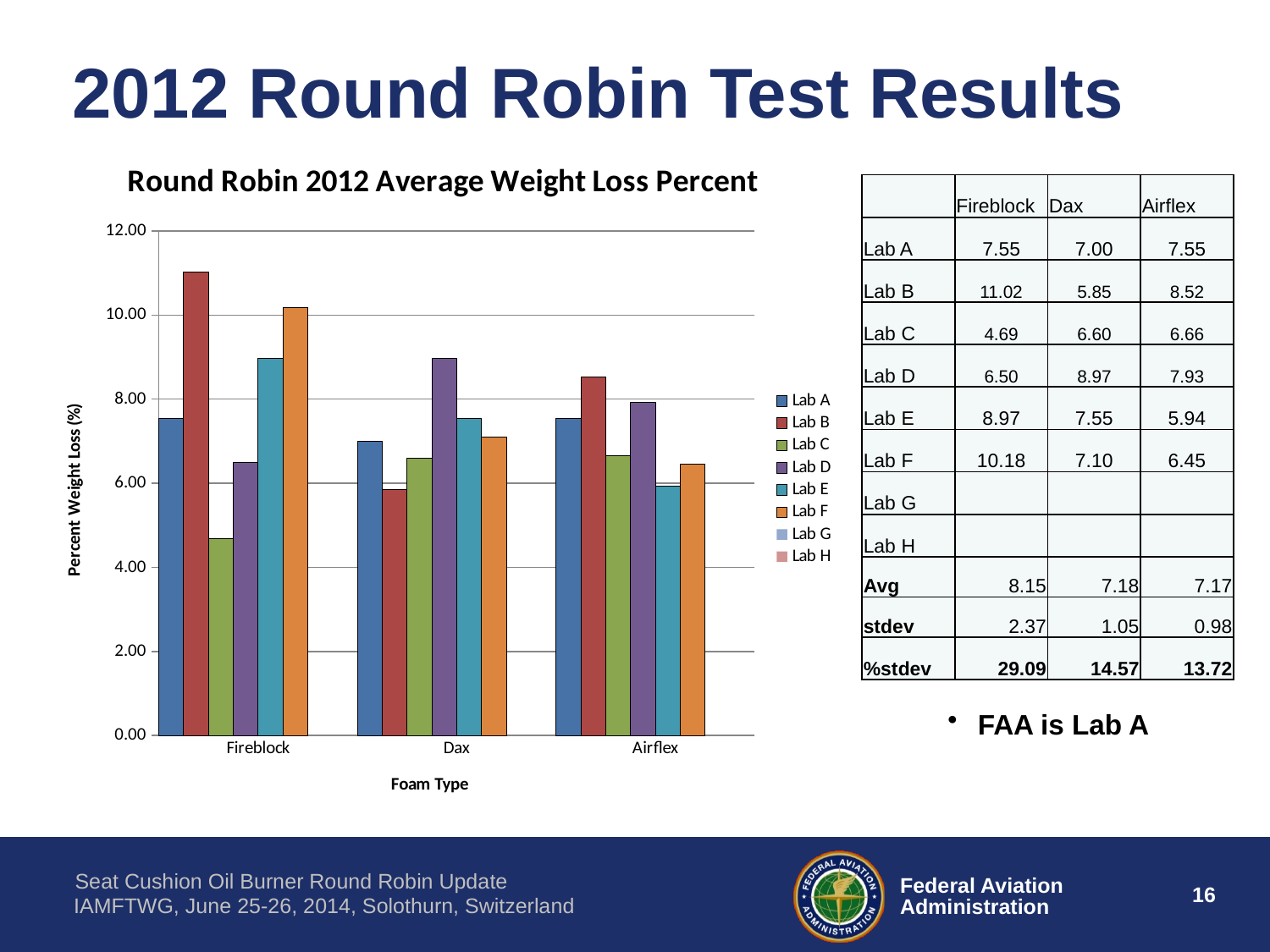
How many series does the chart legend list? 8 How many foam type categories are shown on the x axis? 3 Which lab has the lowest weight loss percent for Airflex? Lab E Which lab has the highest weight loss percent for Dax? Lab D Which is larger for Airflex: Lab B or Lab D? Lab B What is the label of the y axis? Percent Weight Loss (%) Is the value for Lab C on Fireblock greater or less than 6.00? less What type of chart is shown on the slide? bar chart Which lab has the lowest weight loss percent for Fireblock? Lab C Which lab has the highest weight loss percent for Fireblock? Lab B What is the title of the chart? Round Robin 2012 Average Weight Loss Percent Is the value for Lab B on Fireblock greater or less than 10.00? greater